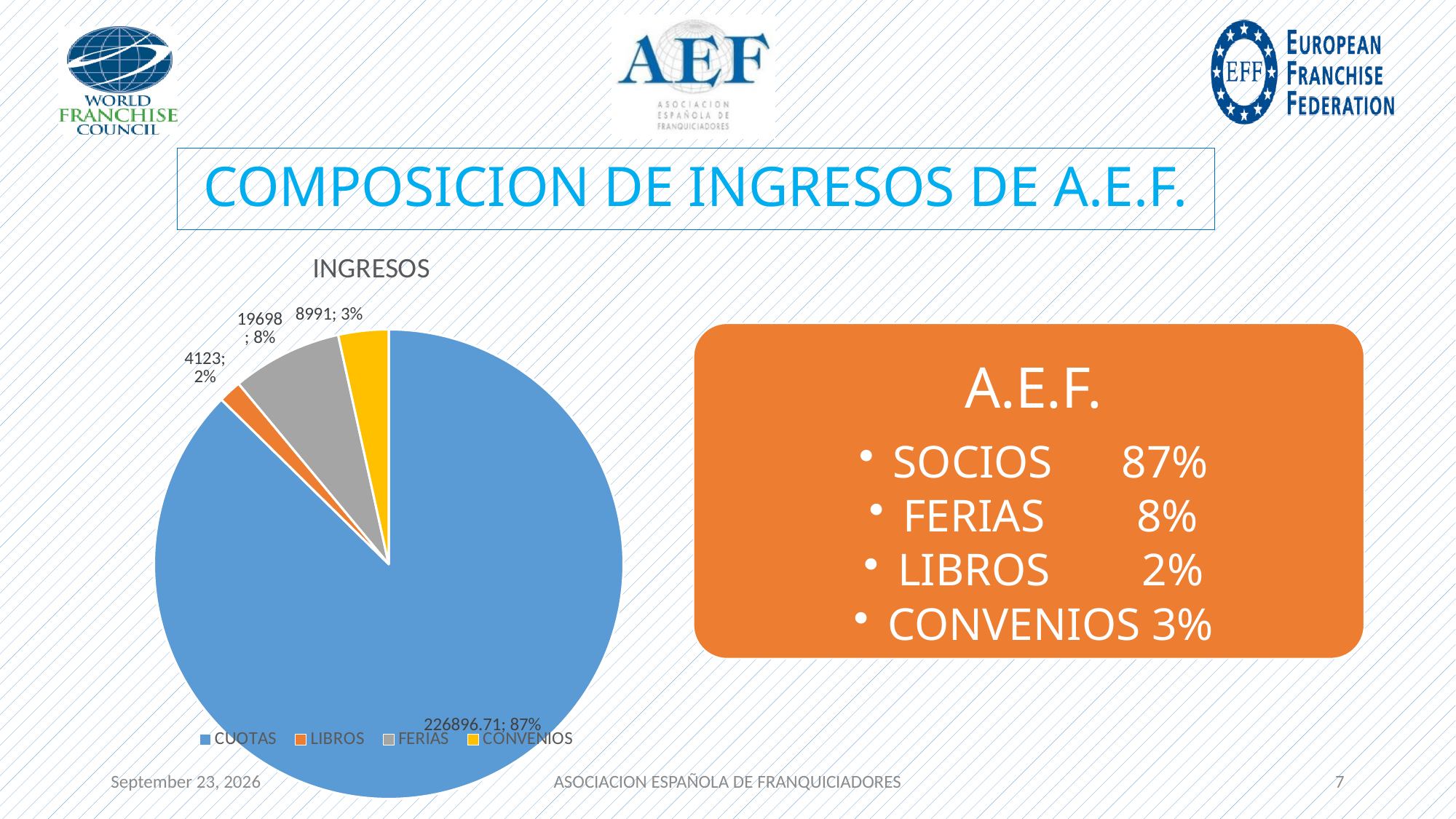
Which category has the largest slice of the pie? CUOTAS What is the value shown for LIBROS? 4123 What is the value shown for CUOTAS? 226896.71 Which category has the smallest slice of the pie? LIBROS What is the value shown for FERIAS? 19698 What is the value shown for CONVENIOS? 8991 What is the title of the chart? INGRESOS What is the difference between the values for FERIAS and CONVENIOS? 10707 Which is larger, the value for CONVENIOS or the value for LIBROS? CONVENIOS What share of the pie does FERIAS represent? 8% How many slices does the pie chart have? 4 What type of chart is shown on the slide? pie chart